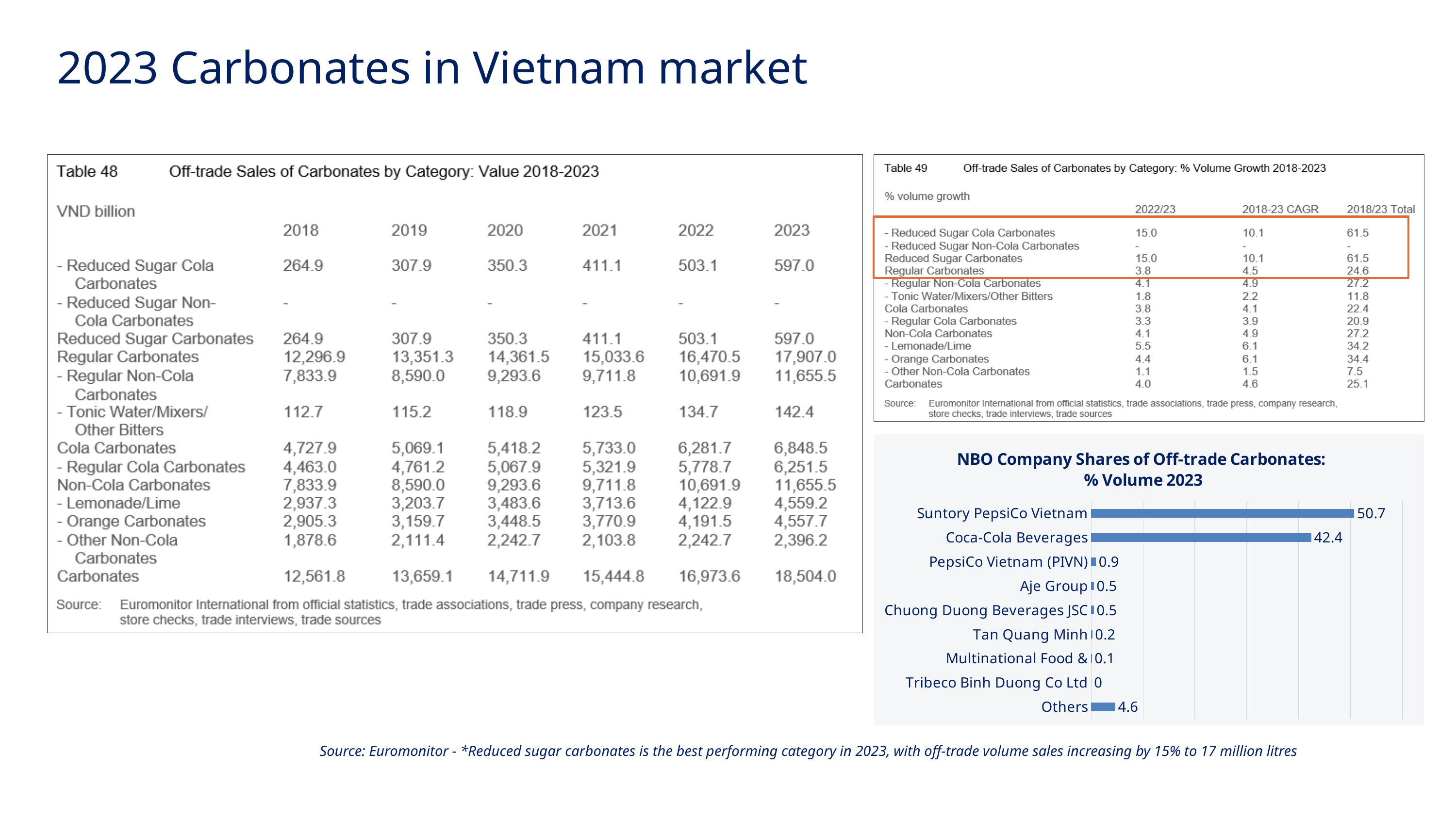
In the NBO Company Shares of Off-trade Carbonates chart, which company has the highest share? Suntory PepsiCo Vietnam In the NBO Company Shares of Off-trade Carbonates chart, which is larger: the value for Others or the value for PepsiCo Vietnam (PIVN)? Others How many companies/categories are shown in the NBO Company Shares of Off-trade Carbonates chart? 9 In the NBO Company Shares of Off-trade Carbonates chart, what is the value for Coca-Cola Beverages? 42.4 In the NBO Company Shares of Off-trade Carbonates chart, what is the difference between the values for Suntory PepsiCo Vietnam and Coca-Cola Beverages? 8.3 In the NBO Company Shares of Off-trade Carbonates chart, which company has the lowest share? Tribeco Binh Duong Co Ltd What is the title of the bar chart on the slide? NBO Company Shares of Off-trade Carbonates: % Volume 2023 What kind of chart is the NBO Company Shares of Off-trade Carbonates chart? Bar chart In the NBO Company Shares of Off-trade Carbonates chart, what is the value for PepsiCo Vietnam (PIVN)? 0.9 In the NBO Company Shares of Off-trade Carbonates chart, what is the difference between the values for Others and PepsiCo Vietnam (PIVN)? 3.7 In the NBO Company Shares of Off-trade Carbonates chart, what is the value for Others? 4.6 In the NBO Company Shares of Off-trade Carbonates chart, what is the value for Suntory PepsiCo Vietnam? 50.7